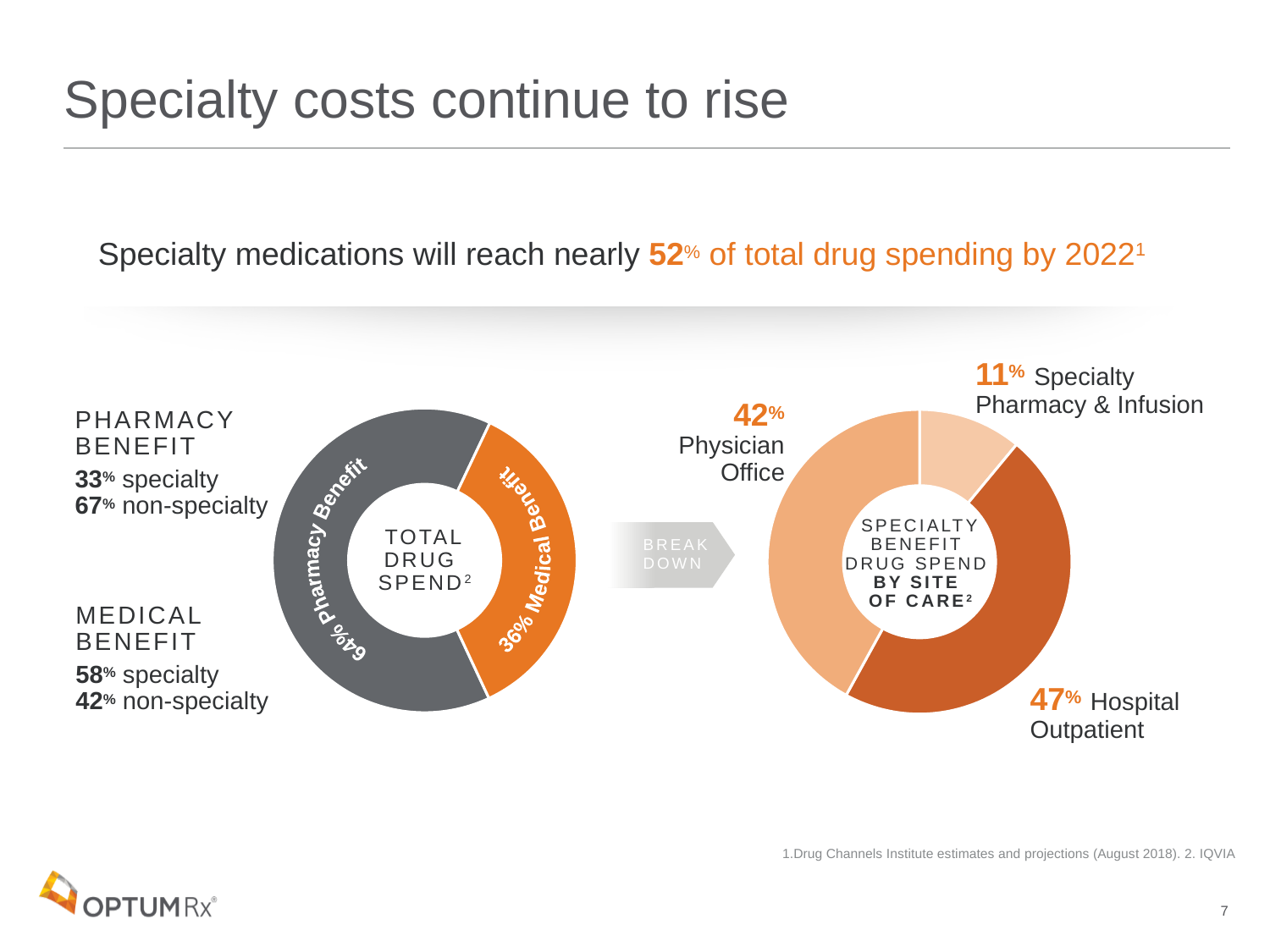
In the Specialty Benefit Drug Spend by Site of Care chart, what share is Specialty Pharmacy & Infusion? 11% In the Specialty Benefit Drug Spend by Site of Care chart, which site of care has the largest share? Hospital Outpatient In the Total Drug Spend chart, what is the difference between the Pharmacy Benefit and Medical Benefit shares? 28% In the Specialty Benefit Drug Spend by Site of Care chart, which site of care has the smallest share? Specialty Pharmacy & Infusion What kind of chart is the Total Drug Spend chart? Donut (pie) chart In the Specialty Benefit Drug Spend by Site of Care chart, what share is Hospital Outpatient? 47% In the Total Drug Spend chart, what share is Pharmacy Benefit? 64% In the Specialty Benefit Drug Spend by Site of Care chart, what share is Physician Office? 42% In the Specialty Benefit Drug Spend by Site of Care chart, what is the difference between the Hospital Outpatient and Physician Office shares? 5% How many segments does the Specialty Benefit Drug Spend by Site of Care chart have? 3 In the Total Drug Spend chart, what share is Medical Benefit? 36% In the Total Drug Spend chart, which segment is larger, Pharmacy Benefit or Medical Benefit? Pharmacy Benefit